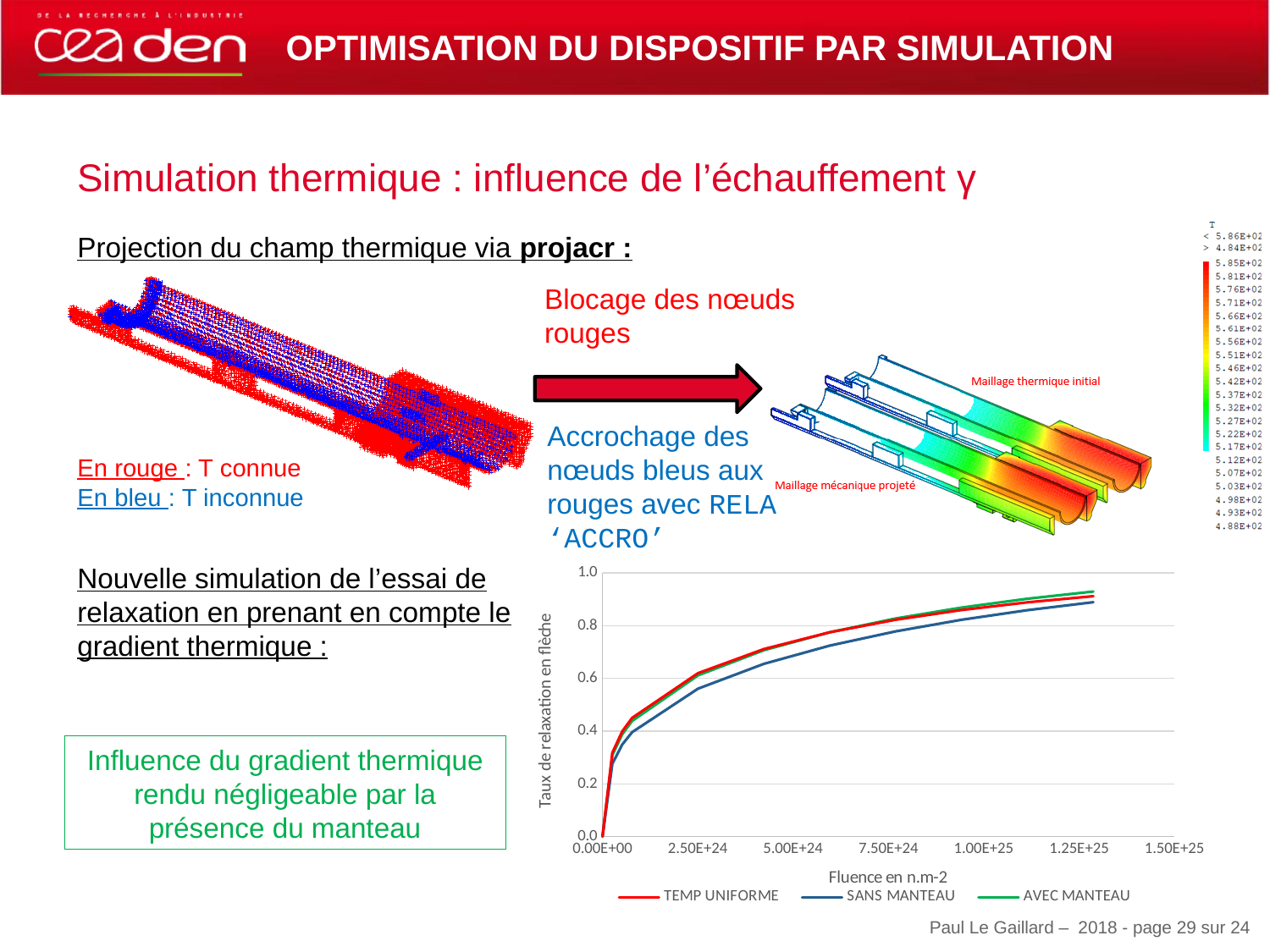
At a fluence of 5.00E+24, is the value for SANS MANTEAU greater or less than 0.6? greater Do the values of the SANS MANTEAU series rise or fall along the x axis? rise What is the title of the x axis of the line chart? Fluence en n.m-2 At a fluence of 1.25E+25, is the value for SANS MANTEAU greater or less than 0.8? greater At a fluence of 5.00E+24, which is larger, the value for AVEC MANTEAU or the value for SANS MANTEAU? AVEC MANTEAU How many series does the legend of the line chart list? 3 Do the values of the TEMP UNIFORME series rise or fall as fluence increases along the x axis? rise What is the maximum value shown on the y axis of the line chart? 1.0 What kind of chart is shown at the bottom right of the slide? line chart Which series has the lowest value at the right end of the line chart (around 1.25E+25)? SANS MANTEAU At a fluence of 2.50E+24, is the value for TEMP UNIFORME greater or less than 0.8? less What are the three series named in the legend of the line chart? TEMP UNIFORME, SANS MANTEAU, AVEC MANTEAU